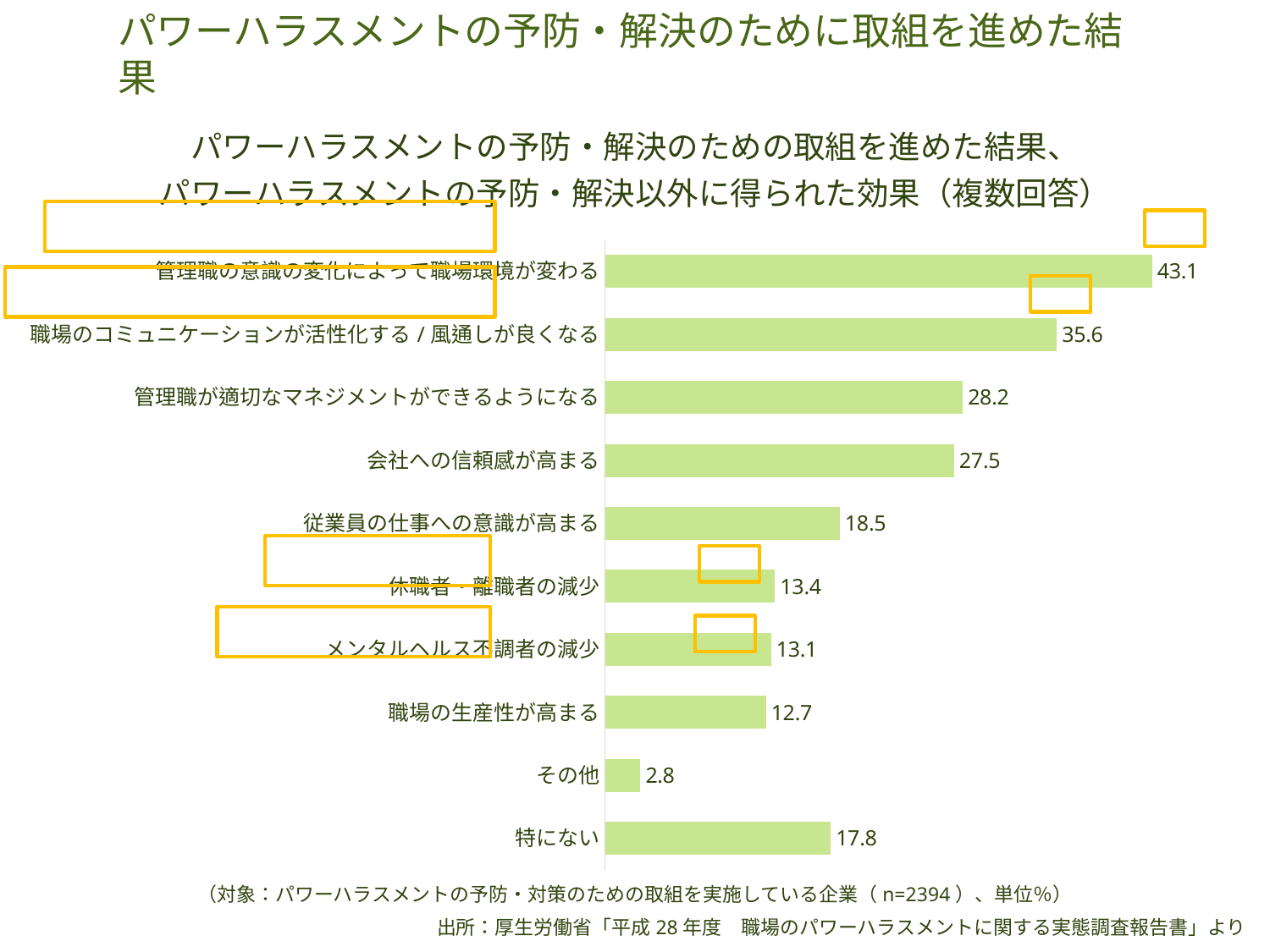
What is the difference between the values for 従業員の仕事への意識が高まる and 特にない? 0.7 What is the value for 職場の生産性が高まる? 12.7 Which category has the lowest value? その他 How many categories are shown in the chart? 10 What is the value for 管理職の意識の変化によって職場環境が変わる? 43.1 What is the value for 会社への信頼感が高まる? 27.5 What is the difference between the values for 管理職の意識の変化によって職場環境が変わる and 職場のコミュニケーションが活性化する / 風通しが良くなる? 7.5 Which is larger, the value for 管理職が適切なマネジメントができるようになる or the value for 会社への信頼感が高まる? 管理職が適切なマネジメントができるようになる What is the value for 特にない? 17.8 What kind of chart is shown on the slide? Bar chart Which category has the highest value? 管理職の意識の変化によって職場環境が変わる What is the sample size (n) stated below the chart? n=2394